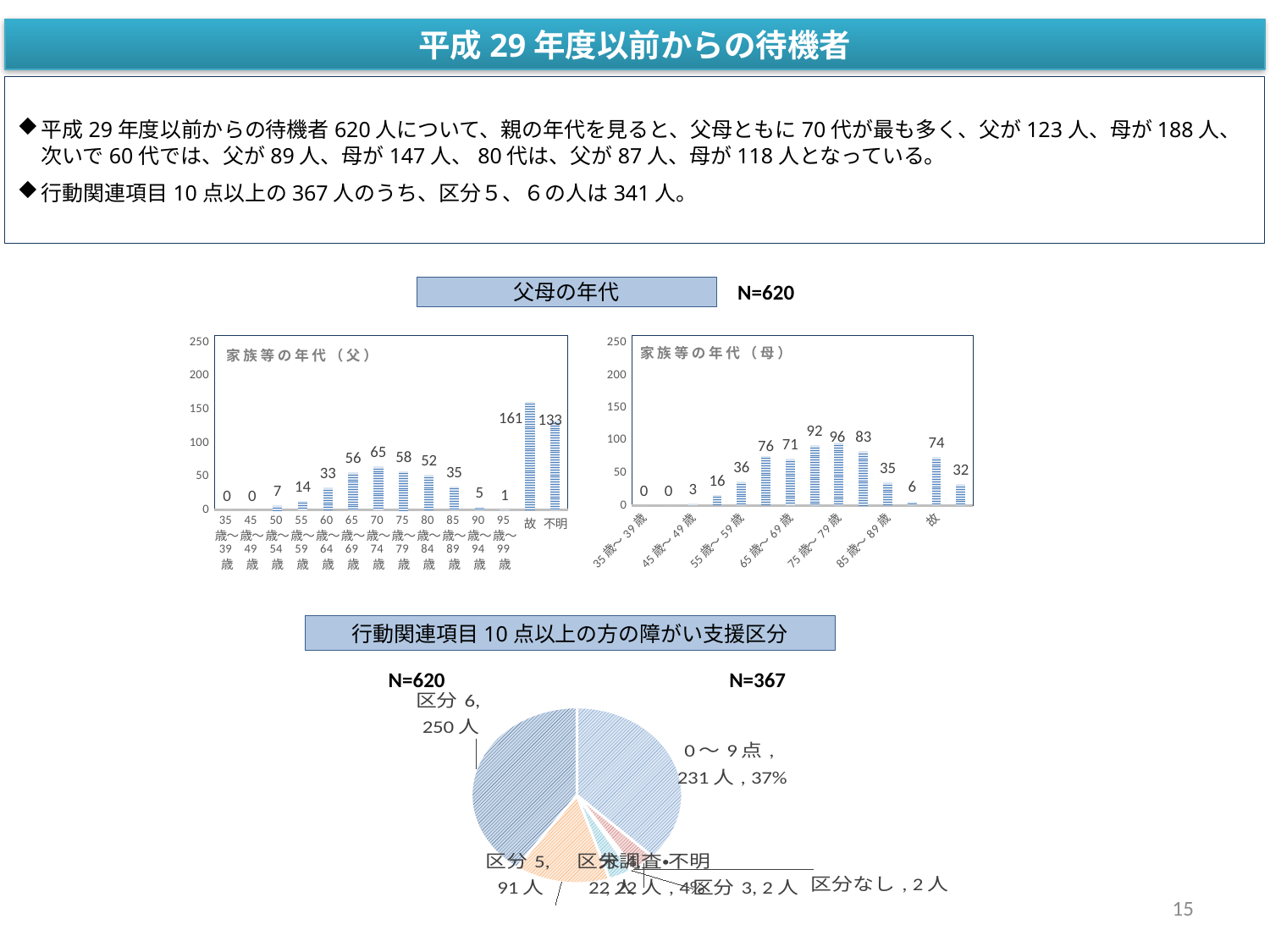
In the 家族等の年代（母） chart, what is the value for 故? 74 In the 家族等の年代（父） chart, what is the difference between the values for 故 and 不明? 28 How many categories are shown on the x axis of the 家族等の年代（父） chart? 14 In the 家族等の年代（父） chart, which category has the highest value? 故 In the 家族等の年代（父） chart, what is the value for 70歳〜74歳? 65 What kind of chart is the 家族等の年代（父） chart? bar chart In the 家族等の年代（母） chart, which is larger, the value for 75歳〜79歳 or the value for 故? 75歳〜79歳 In the 家族等の年代（父） chart, what is the value for 不明? 133 In the 家族等の年代（父） chart, what is the value for 60歳〜64歳? 33 In the 家族等の年代（母） chart, what is the value for 75歳〜79歳? 96 In the pie chart under 行動関連項目10点以上の方の障がい支援区分, what share does 0〜9点 represent? 37% In the pie chart under 行動関連項目10点以上の方の障がい支援区分, how many people are in 区分6? 250人